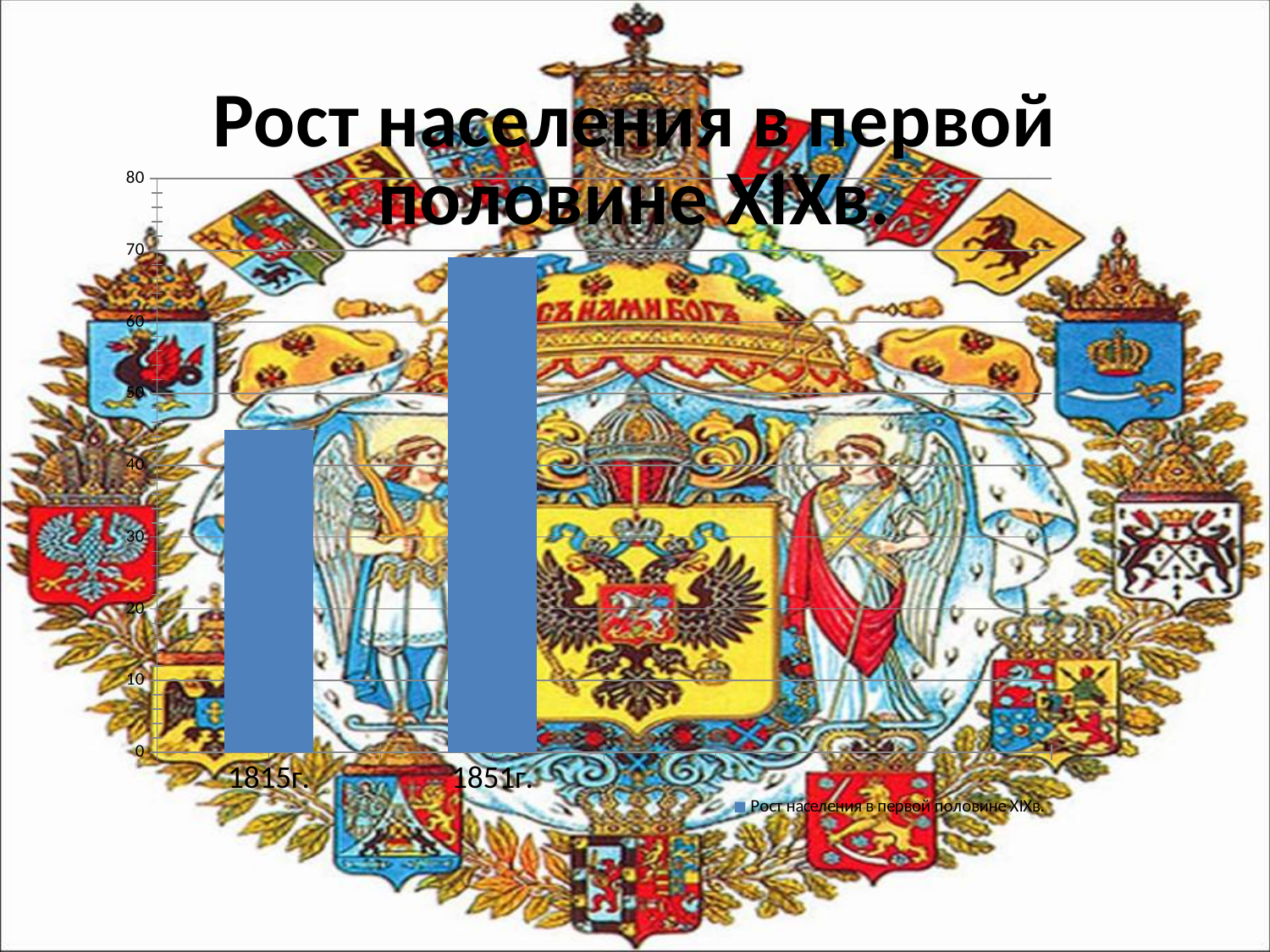
What kind of chart is shown on the slide? bar chart Do the values rise or fall from 1815г. to 1851г.? rise Is the value for 1851г. greater or less than 60? greater Which category has the highest bar in the chart? 1851г. Which category has the lowest bar in the chart? 1815г. Is the value for 1815г. greater or less than 50? less What is the title of the chart on the slide? Рост населения в первой половине XIXв. How many series does the chart's legend list? 1 How many categories are plotted on the x axis of the chart? 2 What is the highest value shown on the chart's vertical axis? 80 Is the value for 1815г. greater or less than 40? greater Which is larger, the value for 1815г. or the value for 1851г.? 1851г.